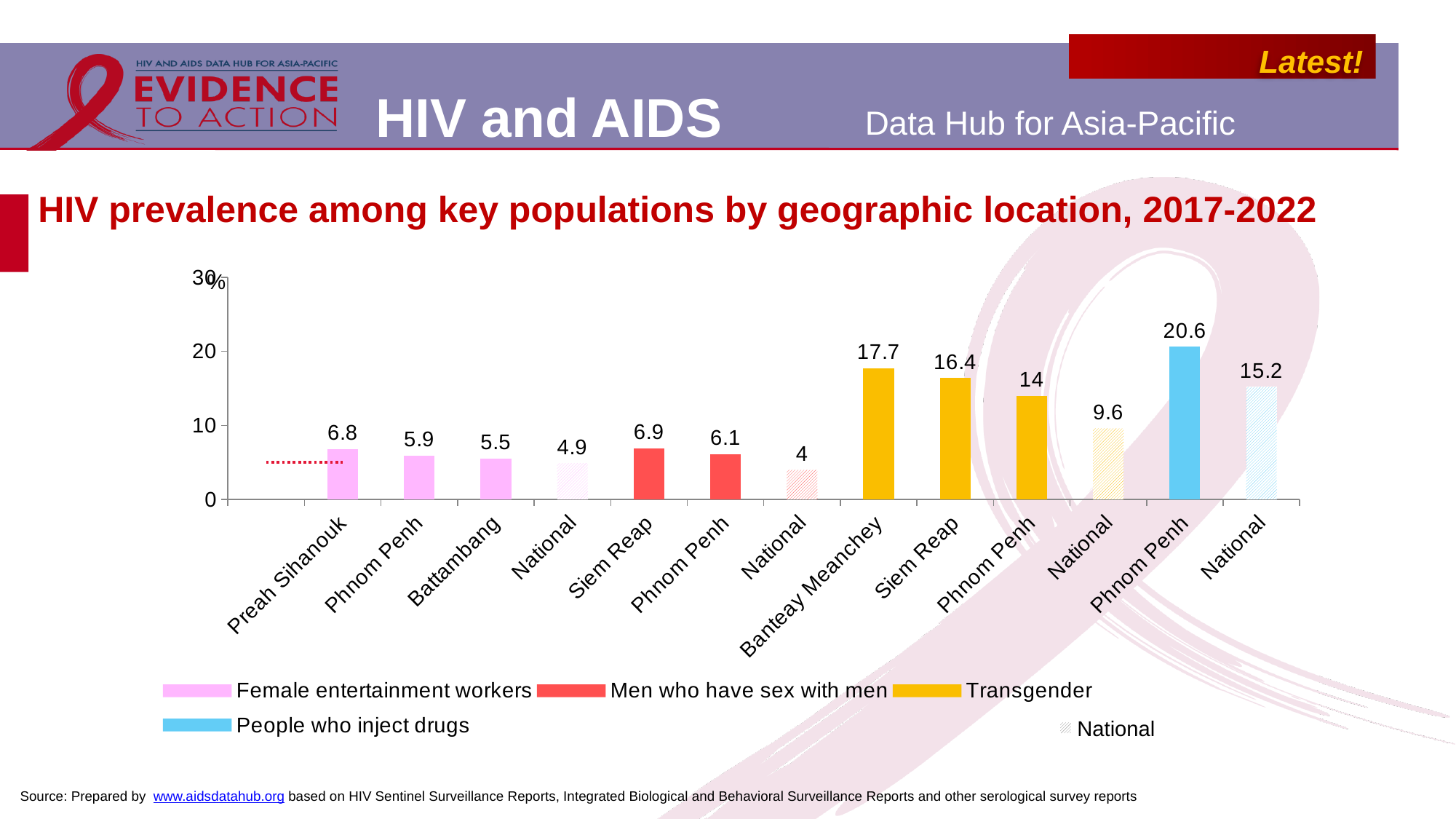
What is the value for Banteay Meanchey among transgender people? 17.7 Which is larger: the Phnom Penh value for female entertainment workers or the Phnom Penh value for men who have sex with men? Men who have sex with men (6.1) How many bars are plotted on the chart? 13 What is the national value for men who have sex with men? 4 How many entries does the legend list? 5 What is the difference between the Siem Reap value for transgender people and the Siem Reap value for men who have sex with men? 9.5 Which bar has the highest value on the chart? Phnom Penh (people who inject drugs), 20.6 What is the value for Phnom Penh among people who inject drugs? 20.6 What is the HIV prevalence value for Preah Sihanouk among female entertainment workers? 6.8 Which bar has the lowest value on the chart? National (men who have sex with men), 4 Is the national value for people who inject drugs greater or less than 10? greater What type of chart is shown on the slide? Bar chart